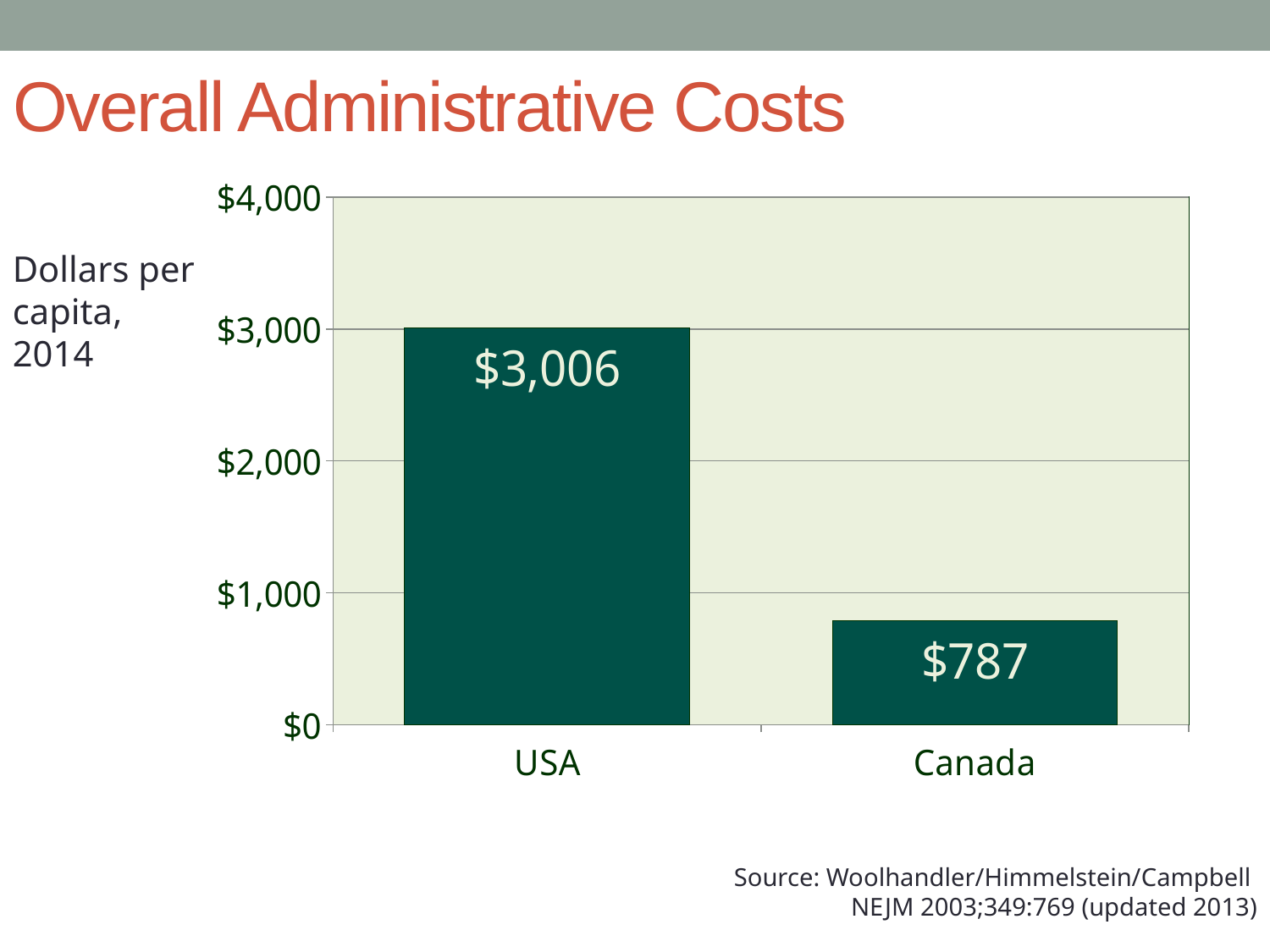
Which is larger, the value for USA or the value for Canada? USA What is the title of the slide? Overall Administrative Costs What unit is the vertical axis measured in, according to the label on the left? Dollars per capita, 2014 What is the value for USA? $3,006 What kind of chart is shown on the slide? bar chart Which category has the highest value? USA What is the difference between the values for USA and Canada? $2,219 Is the value for Canada greater or less than $1,000? less What is the value for Canada? $787 Which category has the lowest value? Canada Is the value for USA greater or less than $3,000? greater How many categories are shown in the chart? 2